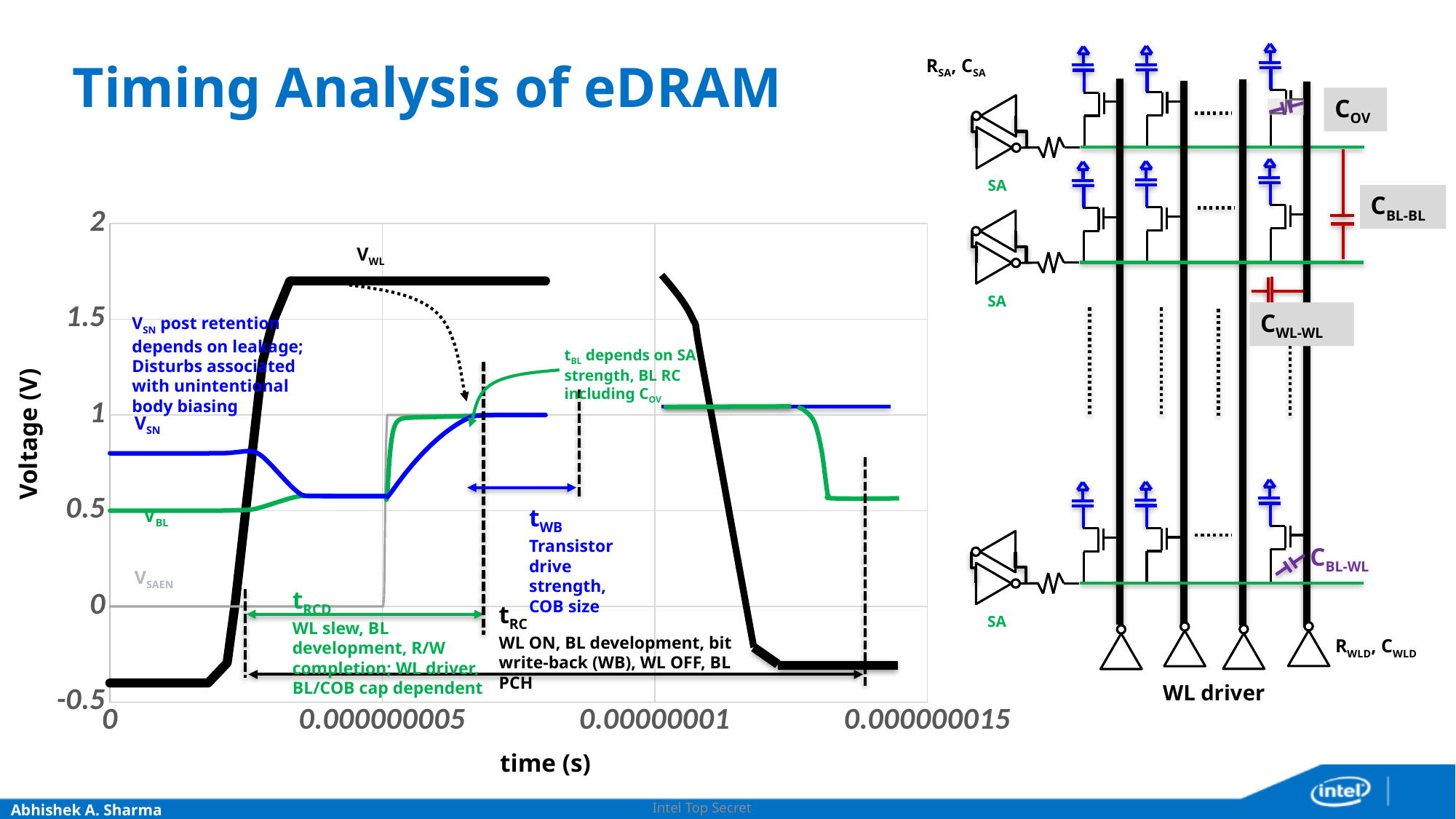
Is the plateau value of V_WL greater or less than 1.5 V? greater How many voltage traces are plotted on the chart? 4 Which trace has the lowest voltage at time 0? V_WL Is the value of V_WL at time 0 greater or less than 0 V? less Does V_WL rise or fall between time 0 and 0.000000005 s? rises What kind of chart is shown on the slide? line chart What is the title of the slide containing the chart? Timing Analysis of eDRAM At time 0, which is larger, V_SN or V_BL? V_SN Is the value of V_SN at time 0 greater or less than 1 V? less What is the label of the vertical axis of the chart? Voltage (V) Does V_WL rise or fall between 0.00000001 s and 0.000000015 s? falls Which trace reaches the highest voltage on the chart? V_WL